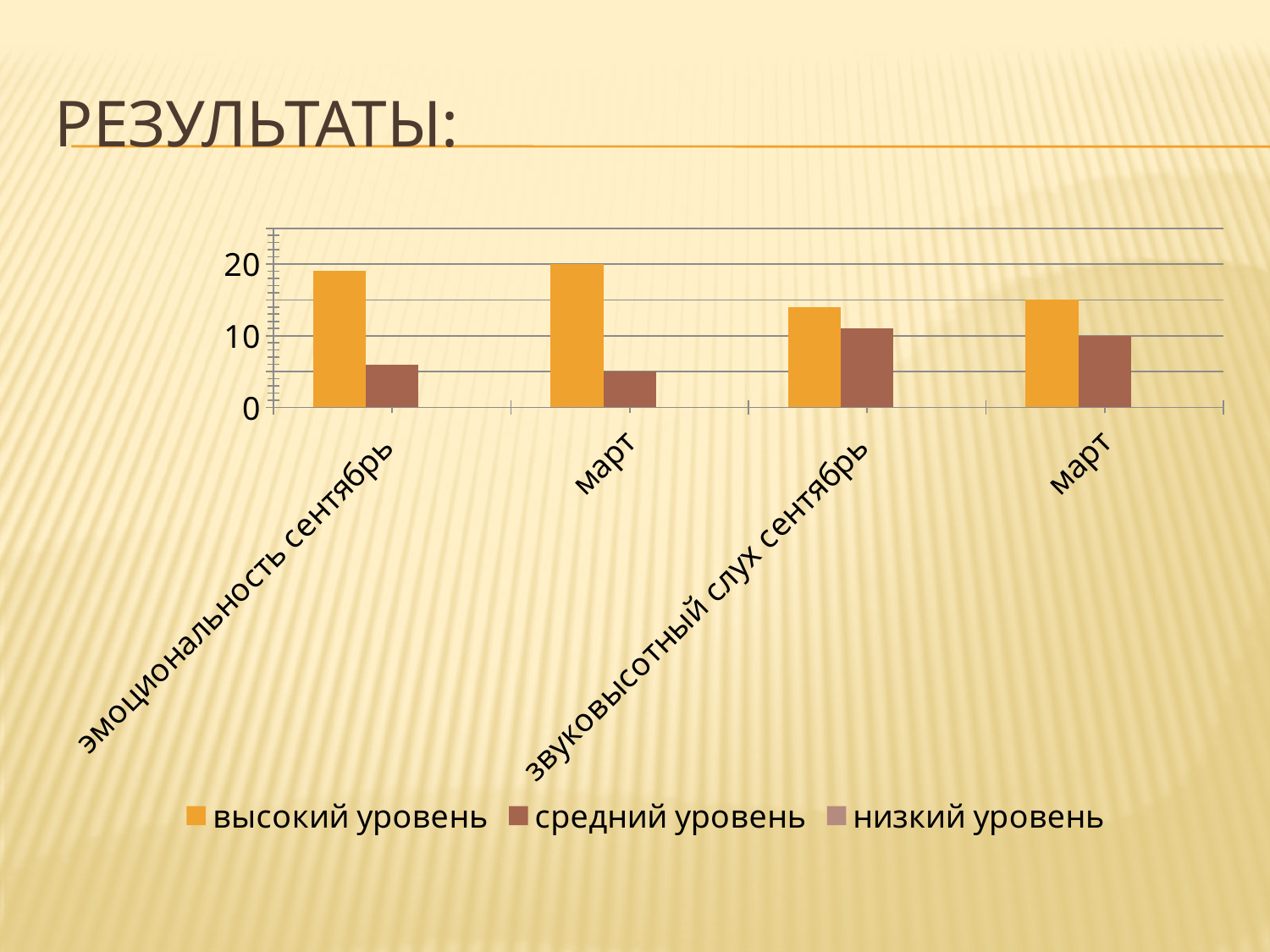
Which legend entry is shown in orange? высокий уровень What is the title of the slide containing the chart? РЕЗУЛЬТАТЫ: How many series does the legend list? 3 Which category has the highest высокий уровень bar? март (the first март, following эмоциональность сентябрь) Is the value of средний уровень for the first март category (following эмоциональность сентябрь) greater or less than 10? less Is the value of средний уровень for эмоциональность сентябрь greater or less than 10? less Is the value of высокий уровень for эмоциональность сентябрь greater or less than 10? greater Which category has the lowest средний уровень bar? март (the first март, following эмоциональность сентябрь) What kind of chart is shown on the slide? bar chart For звуковысотный слух сентябрь, which is larger: высокий уровень or средний уровень? высокий уровень How many categories are shown on the x axis? 4